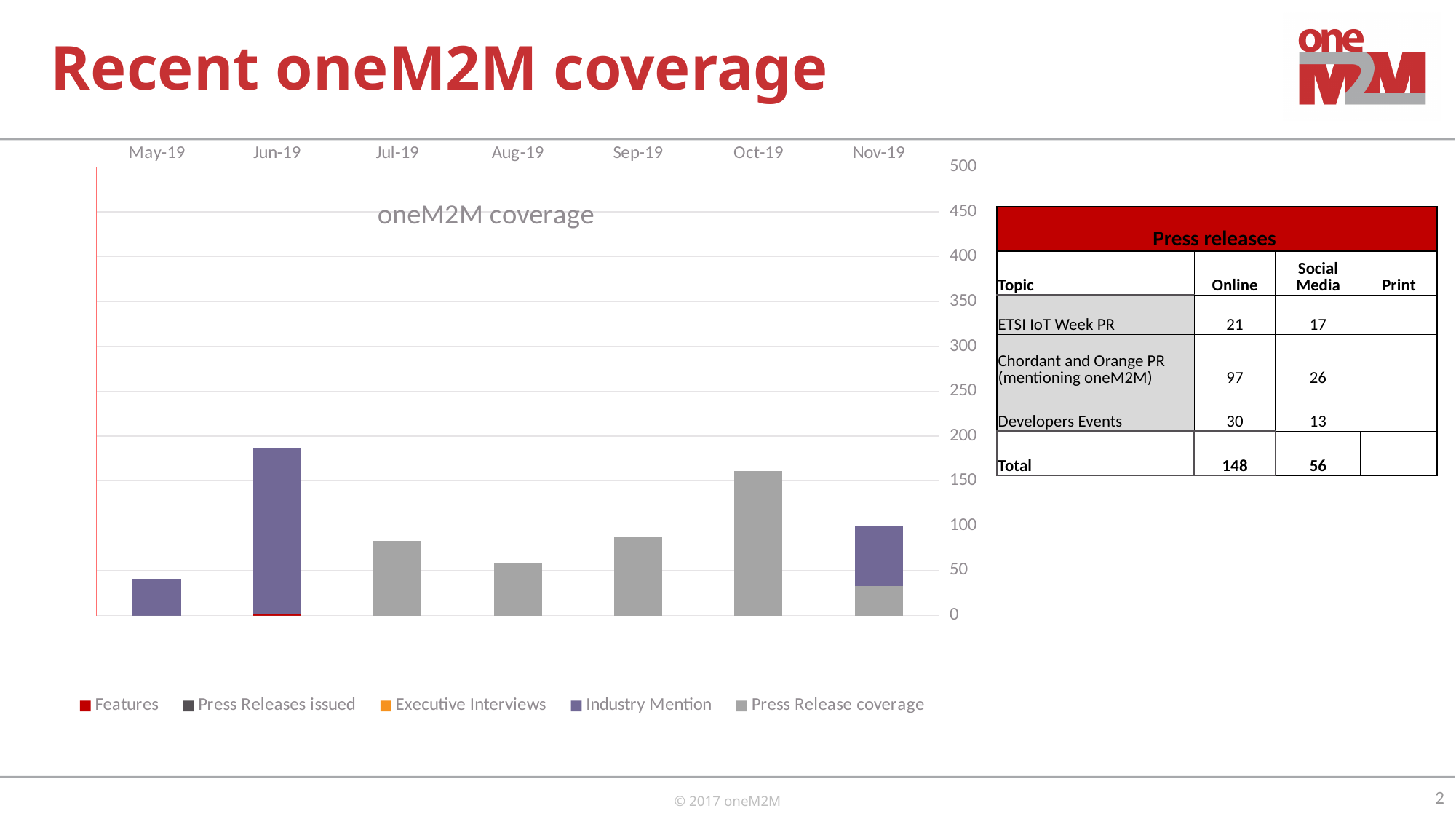
How many months are shown on the x axis of the chart? 7 Which legend series is shown in gray in the chart? Press Release coverage Which month has the shortest bar in the chart? May-19 Is the total bar height for Jun-19 greater or less than 150? greater Is the bar for May-19 greater or less than 50? less Is the bar for Oct-19 greater or less than 100? greater What is the title of the chart? oneM2M coverage Which month has the tallest bar in the chart? Jun-19 What kind of chart is shown on the slide? bar chart Which month has the taller bar, Sep-19 or Oct-19? Oct-19 How many series does the chart legend list? 5